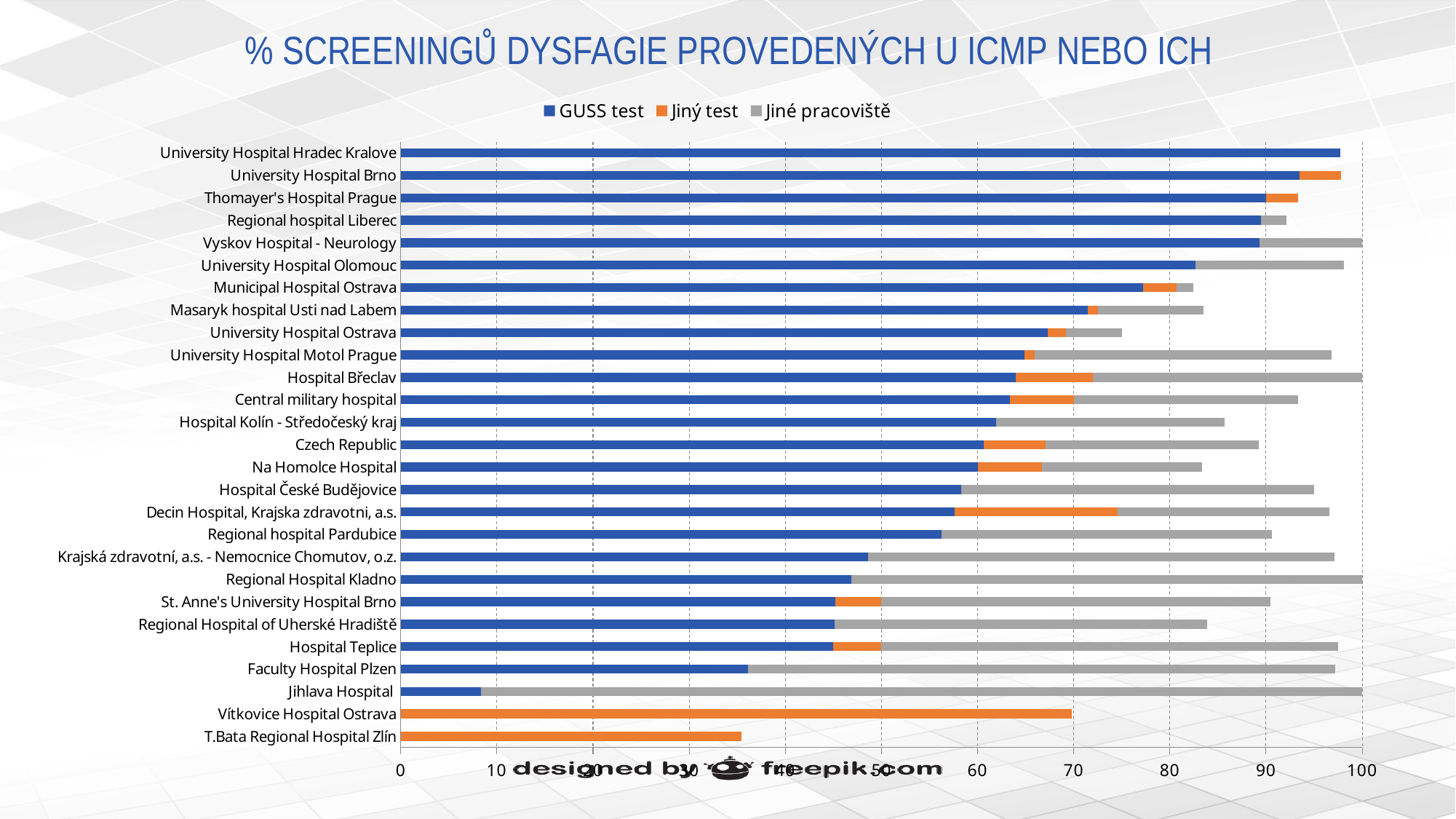
How many series does the legend list? 3 Which category has the longest GUSS test bar? University Hospital Hradec Kralove Is the GUSS test value for Jihlava Hospital greater or less than 10? less Among categories that have a GUSS test bar, which has the shortest one? Jihlava Hospital What kind of chart is shown on the slide? bar chart Is the GUSS test value for Faculty Hospital Plzen greater or less than 40? less Which has a larger GUSS test value, Faculty Hospital Plzen or Jihlava Hospital? Faculty Hospital Plzen Is the GUSS test value for University Hospital Hradec Kralove greater or less than 90? greater How many hospitals/categories are plotted on the chart? 27 Which has a larger GUSS test value, University Hospital Brno or Thomayer's Hospital Prague? University Hospital Brno What are the three series named in the legend? GUSS test, Jiný test, Jiné pracoviště